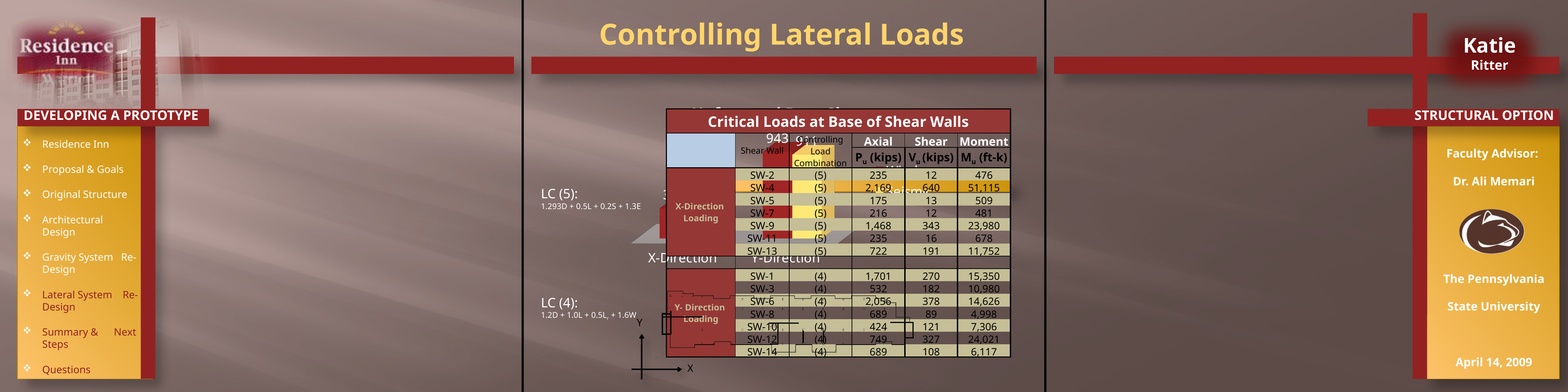
What data label value is readable above a bar in the chart behind the table? 943 What are the two category labels on the x axis of the chart behind the table? X-Direction and Y-Direction How many categories are labelled on the x axis of the chart behind the table? 2 What kind of chart is partially visible behind the table on the slide? Bar chart